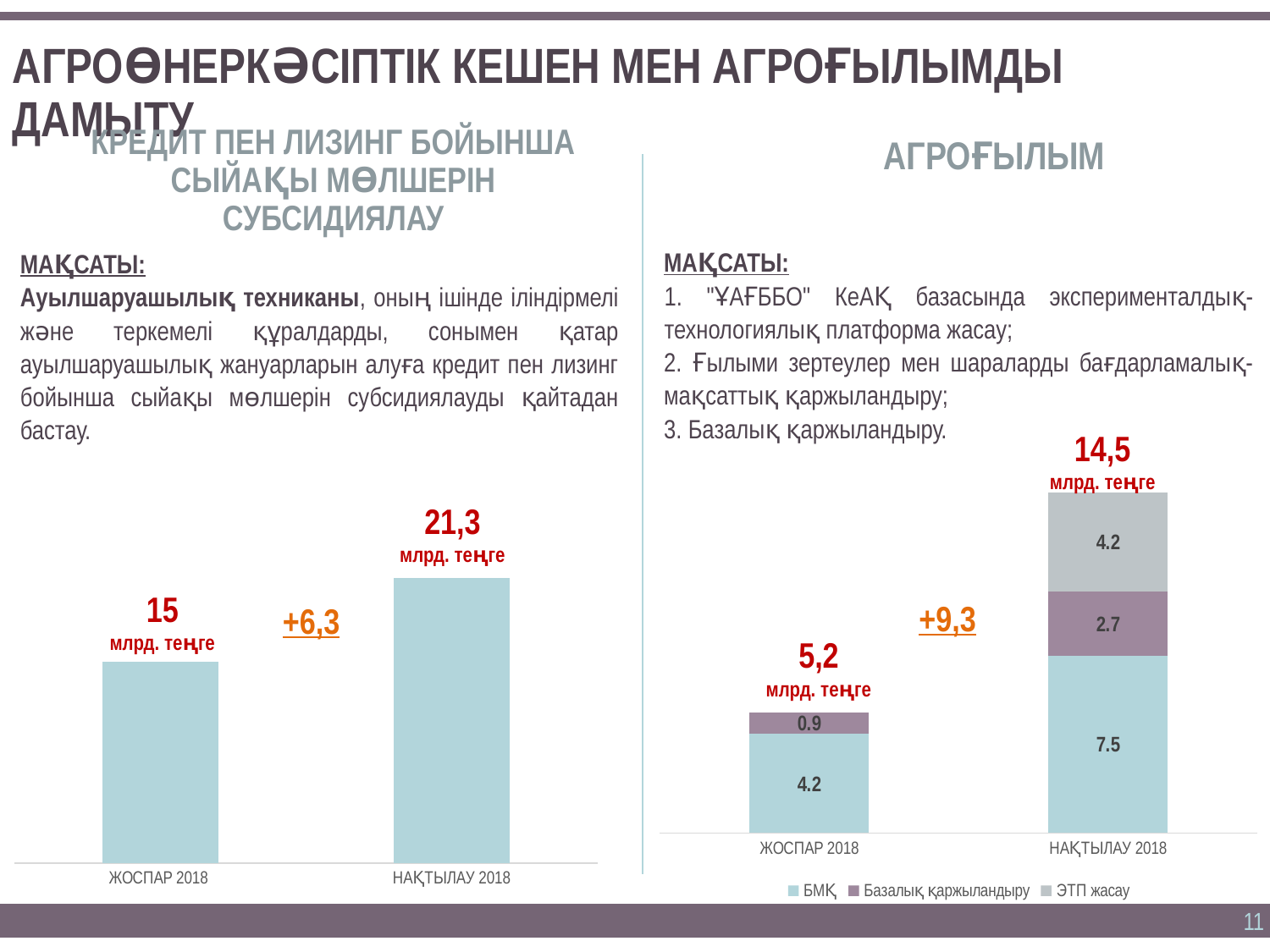
On the left chart, what is the difference between НАҚТЫЛАУ 2018 and ЖОСПАР 2018? +6,3 On the right chart (АГРОҒЫЛЫМ), how many series does the legend list? 3 On the left chart (КРЕДИТ ПЕН ЛИЗИНГ БОЙЫНША СЫЙАҚЫ МӨЛШЕРІН СУБСИДИЯЛАУ), what is the value for ЖОСПАР 2018? 15 млрд. теңге On the left chart, which category has the higher value, ЖОСПАР 2018 or НАҚТЫЛАУ 2018? НАҚТЫЛАУ 2018 On the right chart (АГРОҒЫЛЫМ), what is the total of the НАҚТЫЛАУ 2018 stacked bar? 14,5 млрд. теңге On the left chart, how many bars are plotted? 2 On the right chart (АГРОҒЫЛЫМ), what is the difference between the НАҚТЫЛАУ 2018 total and the ЖОСПАР 2018 total? +9,3 What type of chart is the left chart? Bar chart On the right chart (АГРОҒЫЛЫМ), what is the Базалық қаржыландыру value for ЖОСПАР 2018? 0.9 On the right chart (АГРОҒЫЛЫМ), what is the ЭТП жасау value for НАҚТЫЛАУ 2018? 4.2 On the right chart (АГРОҒЫЛЫМ), what is the БМҚ value for НАҚТЫЛАУ 2018? 7.5 On the left chart, what is the value for НАҚТЫЛАУ 2018? 21,3 млрд. теңге